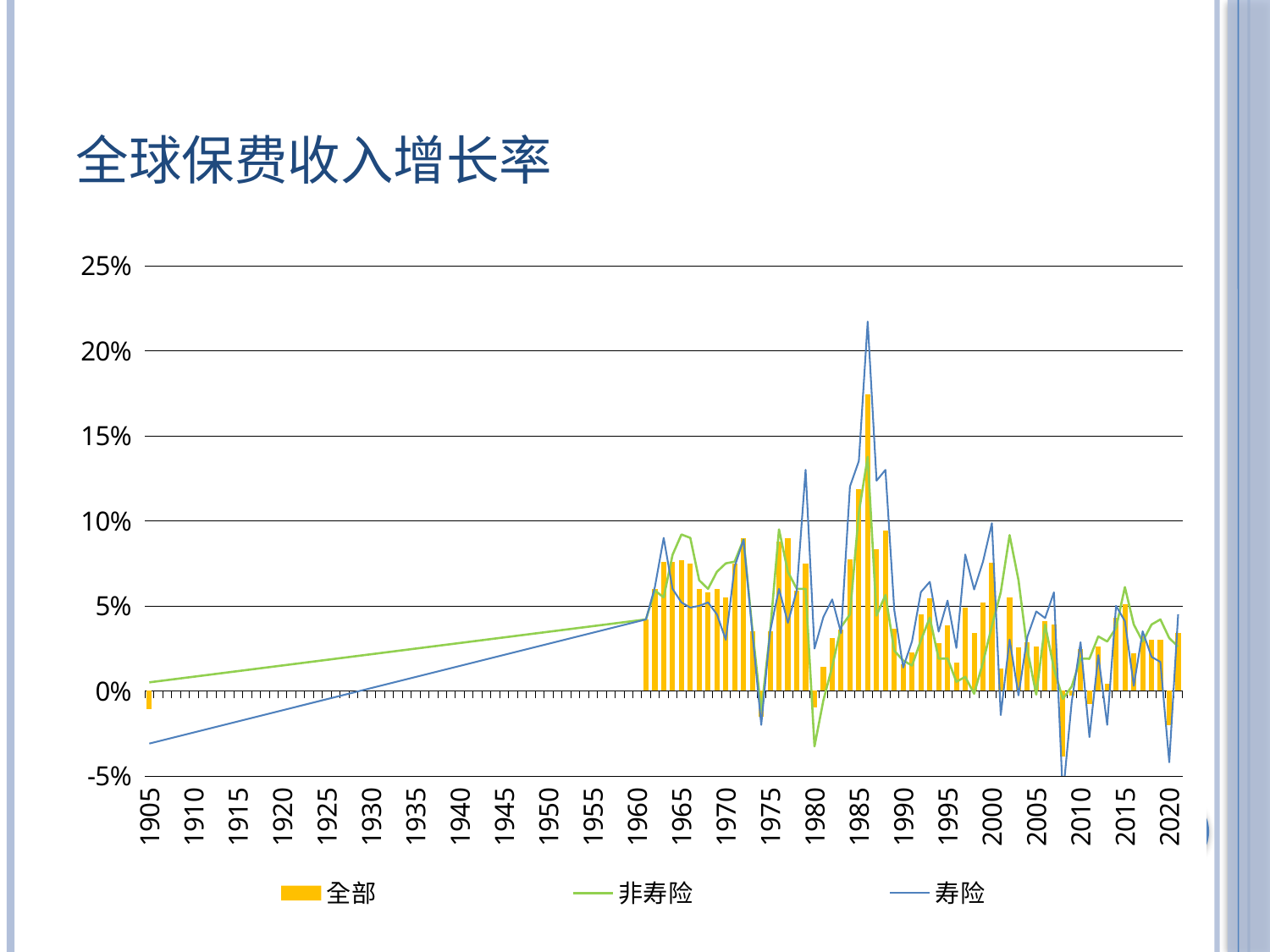
Which series is drawn as bars? 全部 Is the peak value of the 寿险 line greater or less than 20%? greater Does the 寿险 line rise or fall between 1905 and 1960? rise Which series reaches the lowest value on the chart? 寿险 What kind of chart is this? A combined bar and line chart Is the tallest 全部 bar greater or less than 15%? greater Is the value of 寿险 in 1905 greater or less than 0%? less How many series does the legend list? 3 What is the title of the chart? 全球保费收入增长率 In 1905, which is higher, 非寿险 or 寿险? 非寿险 Which series reaches the highest value on the chart? 寿险